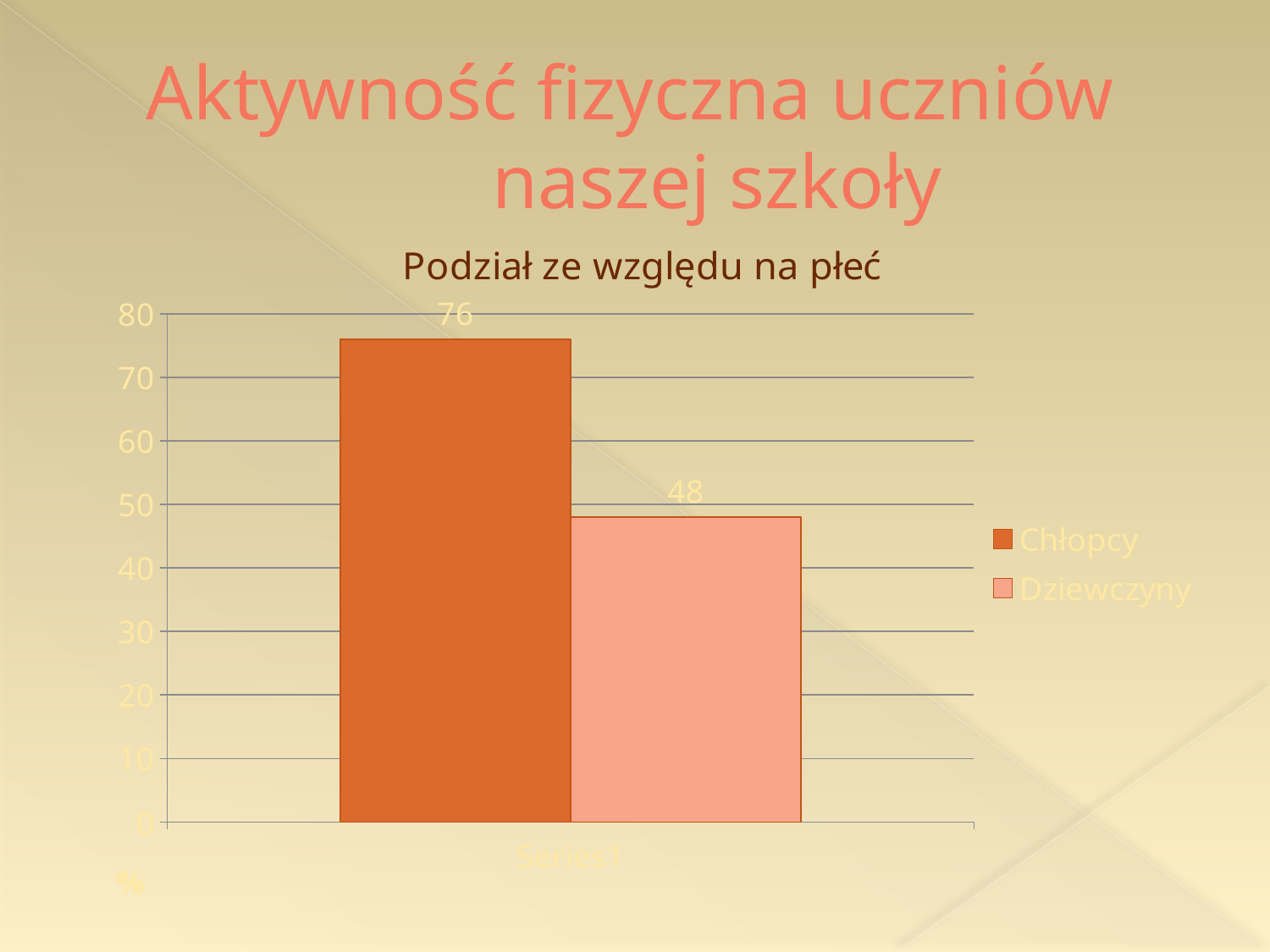
What is the value for Chłopcy? 76 Which series has the lowest value? Dziewczyny What kind of chart is shown on the slide? bar chart What is the highest value shown on the vertical axis? 80 What is the value for Dziewczyny? 48 Is the value for Chłopcy greater or less than 70? greater How many series does the legend list? 2 What is the difference between the values for Chłopcy and Dziewczyny? 28 Is the value for Dziewczyny greater or less than 50? less Which series has the higher value, Chłopcy or Dziewczyny? Chłopcy What is the title of the chart? Podział ze względu na płeć